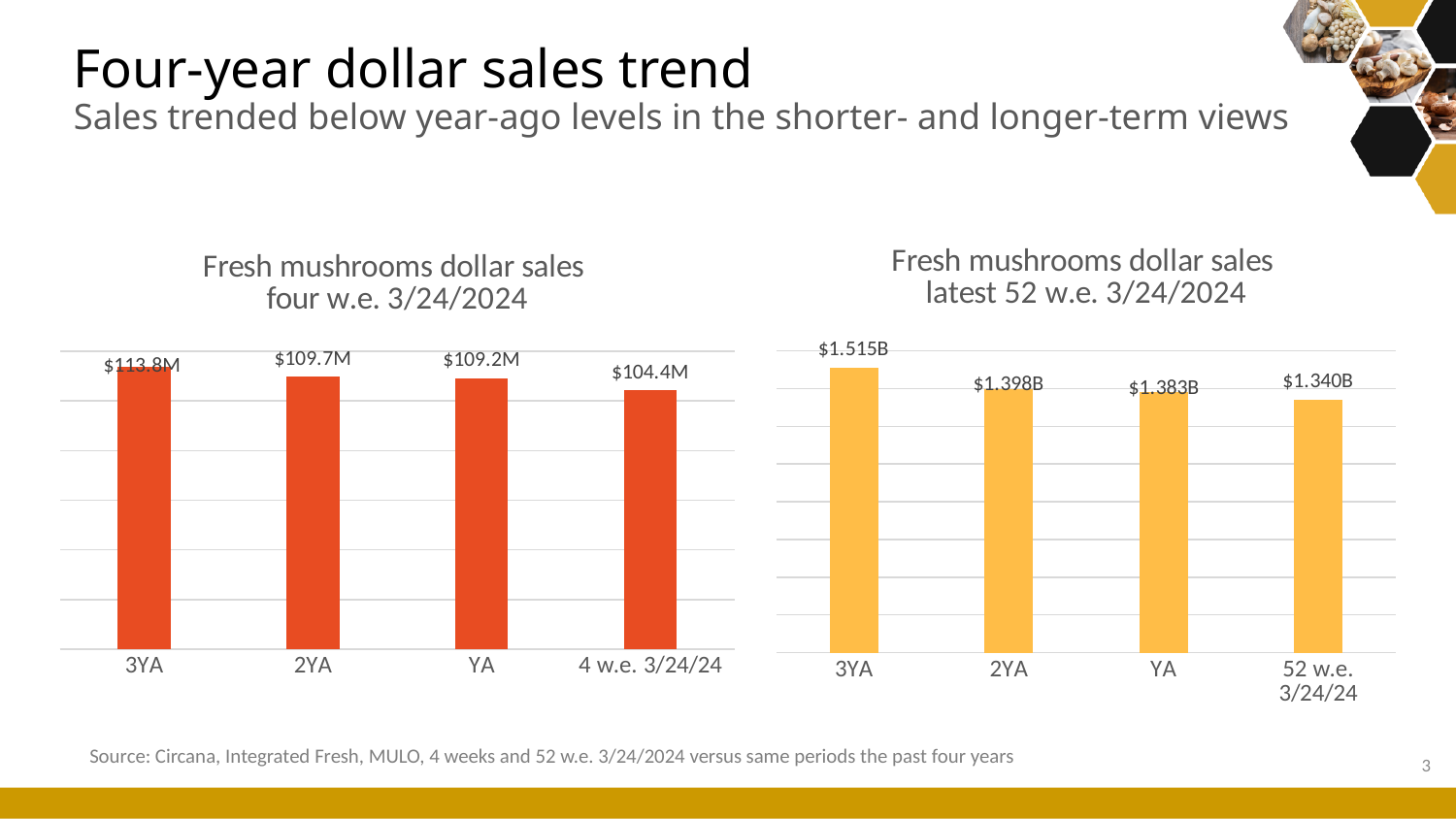
In the 'Fresh mushrooms dollar sales latest 52 w.e. 3/24/2024' chart, do the values rise or fall from 3YA to 52 w.e. 3/24/24? Fall In the 'Fresh mushrooms dollar sales four w.e. 3/24/2024' chart, what is the value for 4 w.e. 3/24/24? $104.4M In the 'Fresh mushrooms dollar sales latest 52 w.e. 3/24/2024' chart, which period has the lowest value? 52 w.e. 3/24/24 In the 'Fresh mushrooms dollar sales latest 52 w.e. 3/24/2024' chart, what is the difference between the 3YA value and the YA value? $0.132B In the 'Fresh mushrooms dollar sales latest 52 w.e. 3/24/2024' chart, what is the value for 52 w.e. 3/24/24? $1.340B In the 'Fresh mushrooms dollar sales four w.e. 3/24/2024' chart, what is the difference between the 3YA value and the 4 w.e. 3/24/24 value? $9.5M How many periods are shown in the 'Fresh mushrooms dollar sales latest 52 w.e. 3/24/2024' chart? 4 In the 'Fresh mushrooms dollar sales four w.e. 3/24/2024' chart, which period has the highest value? 3YA What type of chart is the 'Fresh mushrooms dollar sales four w.e. 3/24/2024' chart? Bar chart In the 'Fresh mushrooms dollar sales four w.e. 3/24/2024' chart, which is larger, the value for 2YA or the value for YA? 2YA In the 'Fresh mushrooms dollar sales four w.e. 3/24/2024' chart, what is the value for 3YA? $113.8M In the 'Fresh mushrooms dollar sales latest 52 w.e. 3/24/2024' chart, what is the value for 2YA? $1.398B